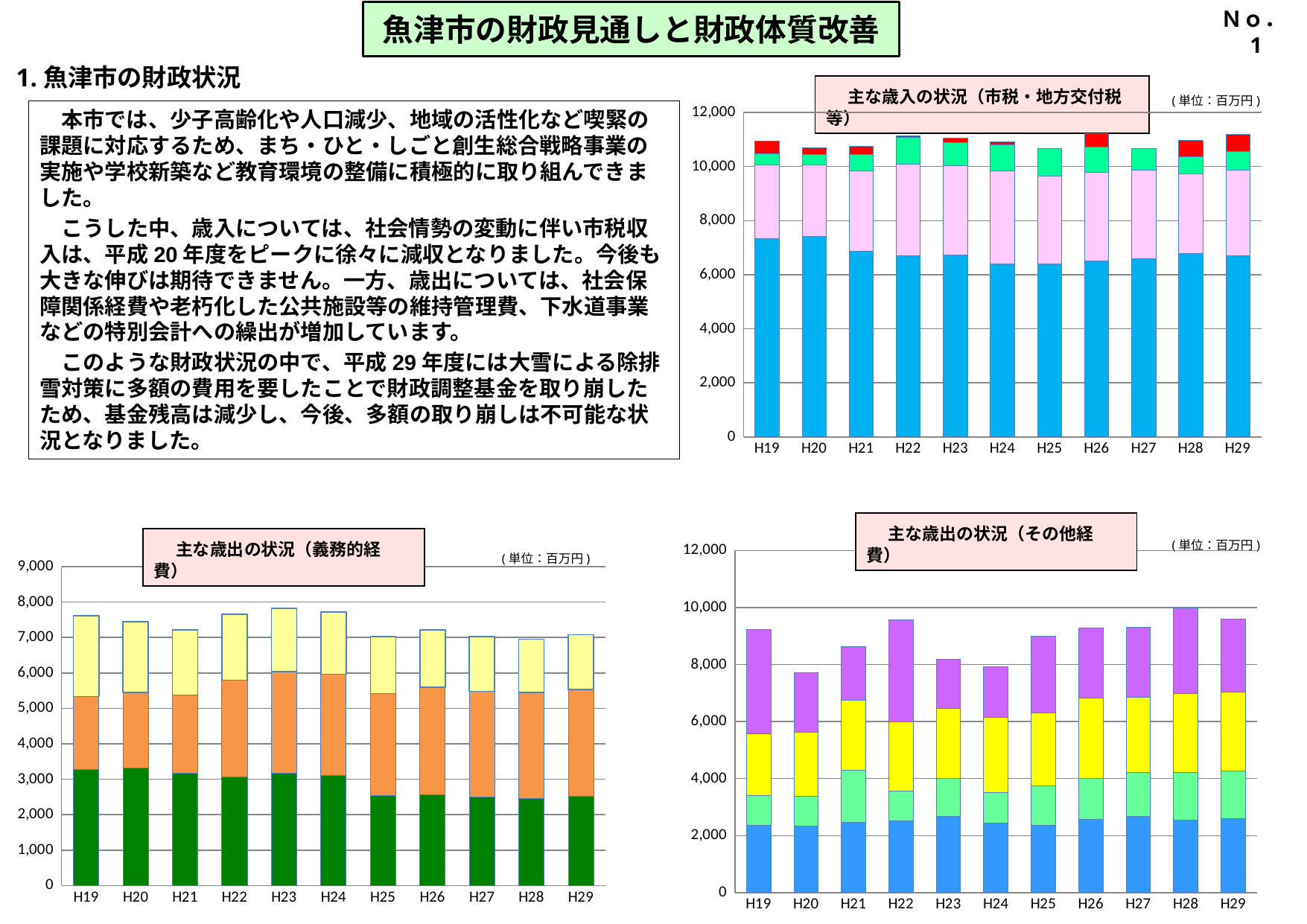
In the "主な歳入の状況（市税・地方交付税等）" chart, is the total bar for H19 greater or less than 10,000? greater In the "主な歳出の状況（義務的経費）" chart, is the total bar for H19 greater or less than 7,000? greater What kind of chart is the "主な歳入の状況（市税・地方交付税等）" chart? stacked bar chart How many fiscal years are shown on the x axis of the "主な歳出の状況（義務的経費）" chart? 11 In the "主な歳出の状況（義務的経費）" chart, which total bar is taller, H23 or H28? H23 In the "主な歳出の状況（その他経費）" chart, is the total bar for H22 greater or less than 9,000? greater What unit is stated for the values in the "主な歳入の状況（市税・地方交付税等）" chart? 百万円 What is the title of the chart at the bottom left of the slide? 主な歳出の状況（義務的経費） In the "主な歳出の状況（その他経費）" chart, which fiscal year has the tallest total bar? H28 In the "主な歳出の状況（その他経費）" chart, which total bar is taller, H28 or H20? H28